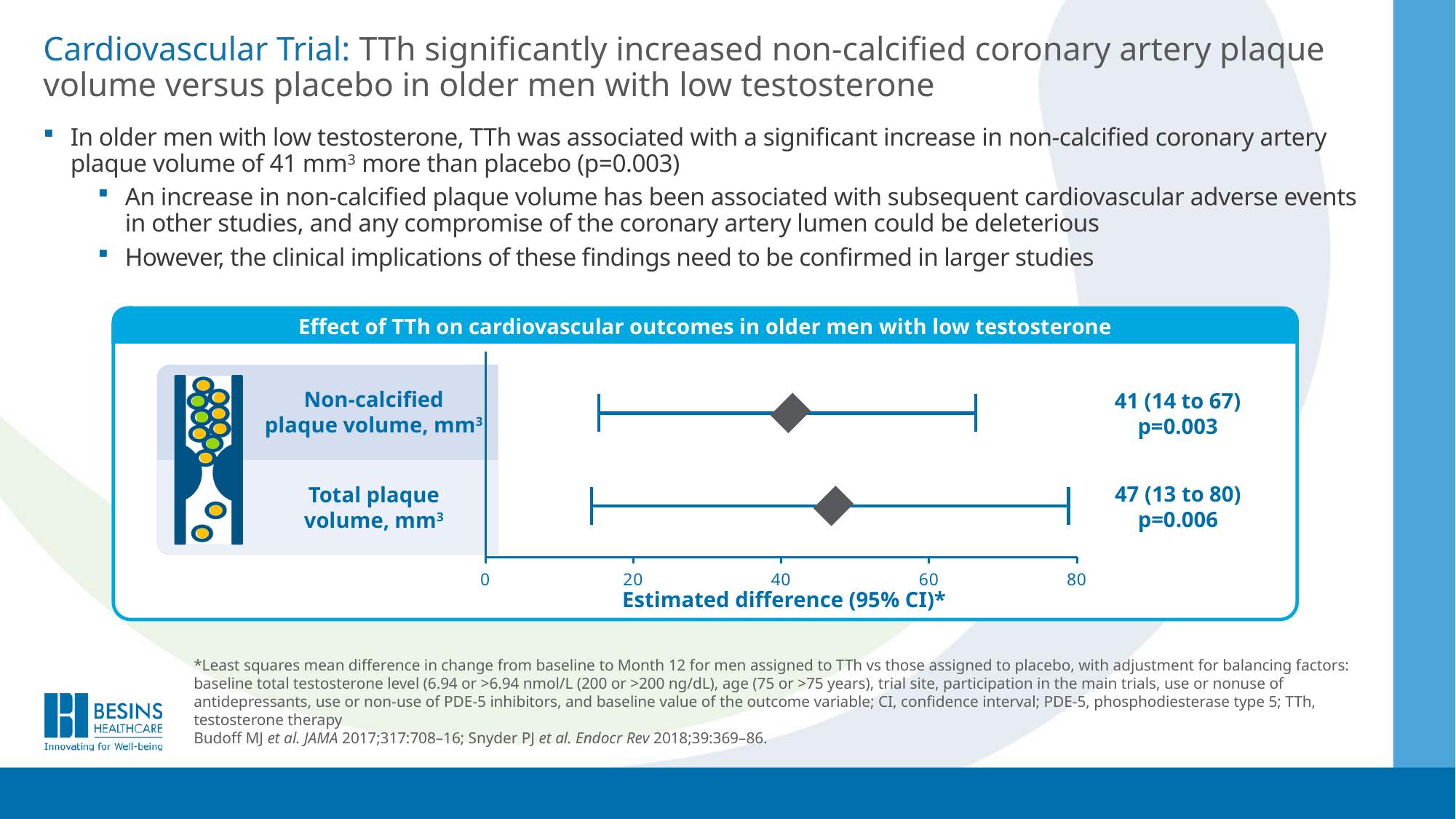
Is the upper confidence limit for non-calcified plaque volume greater or less than 80? less Which outcome has the smallest estimated difference? Non-calcified plaque volume What is the estimated difference for total plaque volume? 47 (13 to 80) What is the estimated difference for non-calcified plaque volume? 41 (14 to 67) What is the label of the x axis? Estimated difference (95% CI)* How many outcomes are plotted in the chart? 2 What is the p-value shown for non-calcified plaque volume? p=0.003 Is the estimated difference for total plaque volume greater or less than 40? greater Which outcome has the larger estimated difference, non-calcified plaque volume or total plaque volume? Total plaque volume What is the difference between the estimated differences for total plaque volume and non-calcified plaque volume? 6 What is the p-value shown for total plaque volume? p=0.006 What is the title of the chart? Effect of TTh on cardiovascular outcomes in older men with low testosterone